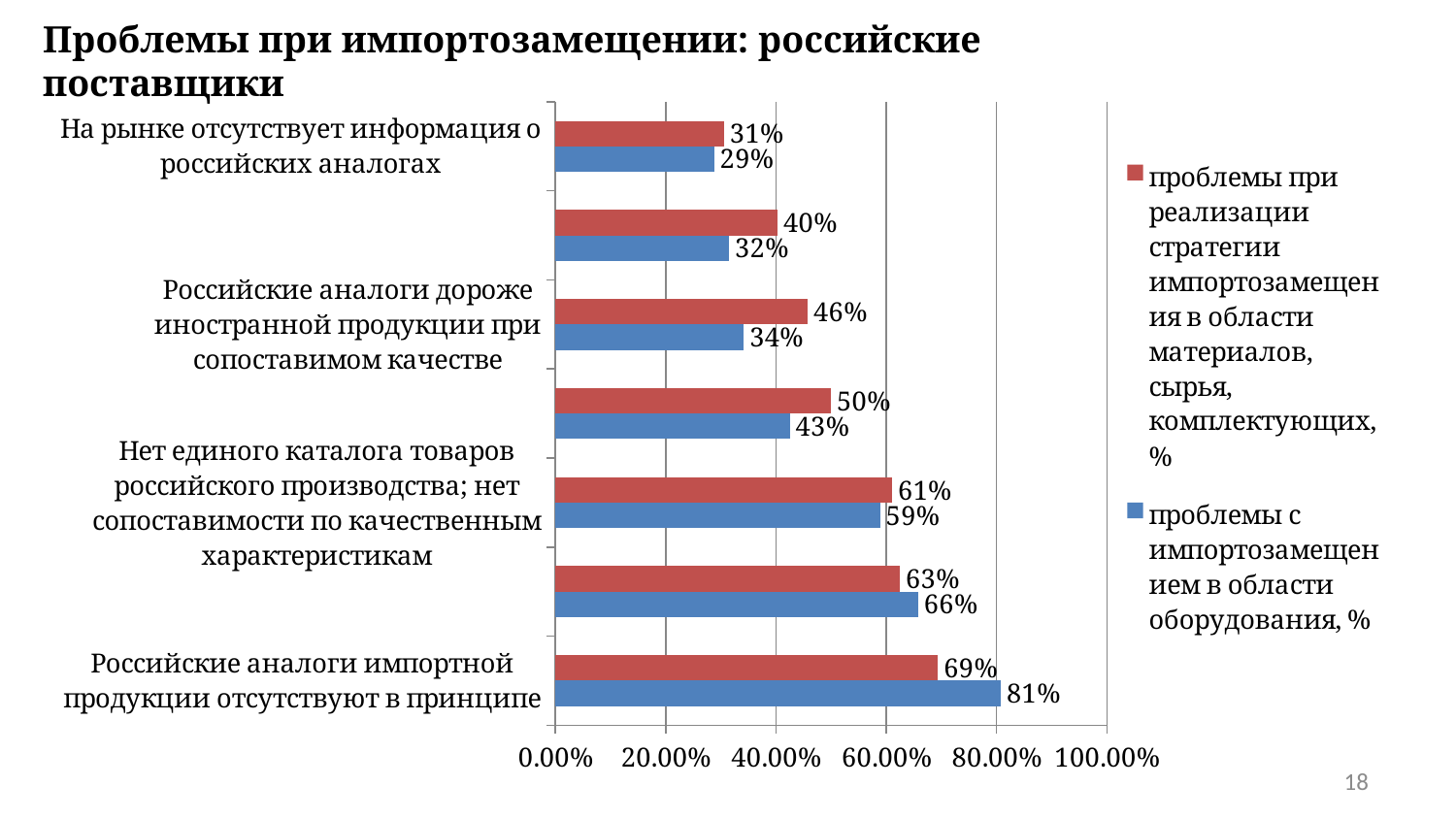
How many series does the legend list? 2 Which category has the lowest value in the 'проблемы при реализации стратегии импортозамещения в области материалов, сырья, комплектующих, %' series? На рынке отсутствует информация о российских аналогах For 'Нет единого каталога товаров российского производства; нет сопоставимости по качественным характеристикам', which series has the larger value? проблемы при реализации стратегии импортозамещения в области материалов, сырья, комплектующих, % What type of chart is shown on the slide? bar chart What is the difference between the two series for 'Российские аналоги дороже иностранной продукции при сопоставимом качестве'? 12% What is the value of the 'проблемы с импортозамещением в области оборудования, %' series for 'Российские аналоги импортной продукции отсутствуют в принципе'? 81% What is the value of the 'проблемы при реализации стратегии импортозамещения в области материалов, сырья, комплектующих, %' series for 'Российские аналоги дороже иностранной продукции при сопоставимом качестве'? 46% Which category has the highest value in the 'проблемы с импортозамещением в области оборудования, %' series? Российские аналоги импортной продукции отсутствуют в принципе What is the value of the 'проблемы при реализации стратегии импортозамещения в области материалов, сырья, комплектующих, %' series for 'Российские аналоги импортной продукции отсутствуют в принципе'? 69% What is the difference between the two series for 'Российские аналоги импортной продукции отсутствуют в принципе'? 12% What is the value of the 'проблемы с импортозамещением в области оборудования, %' series for 'На рынке отсутствует информация о российских аналогах'? 29% How many pairs of bars are plotted in the chart? 7